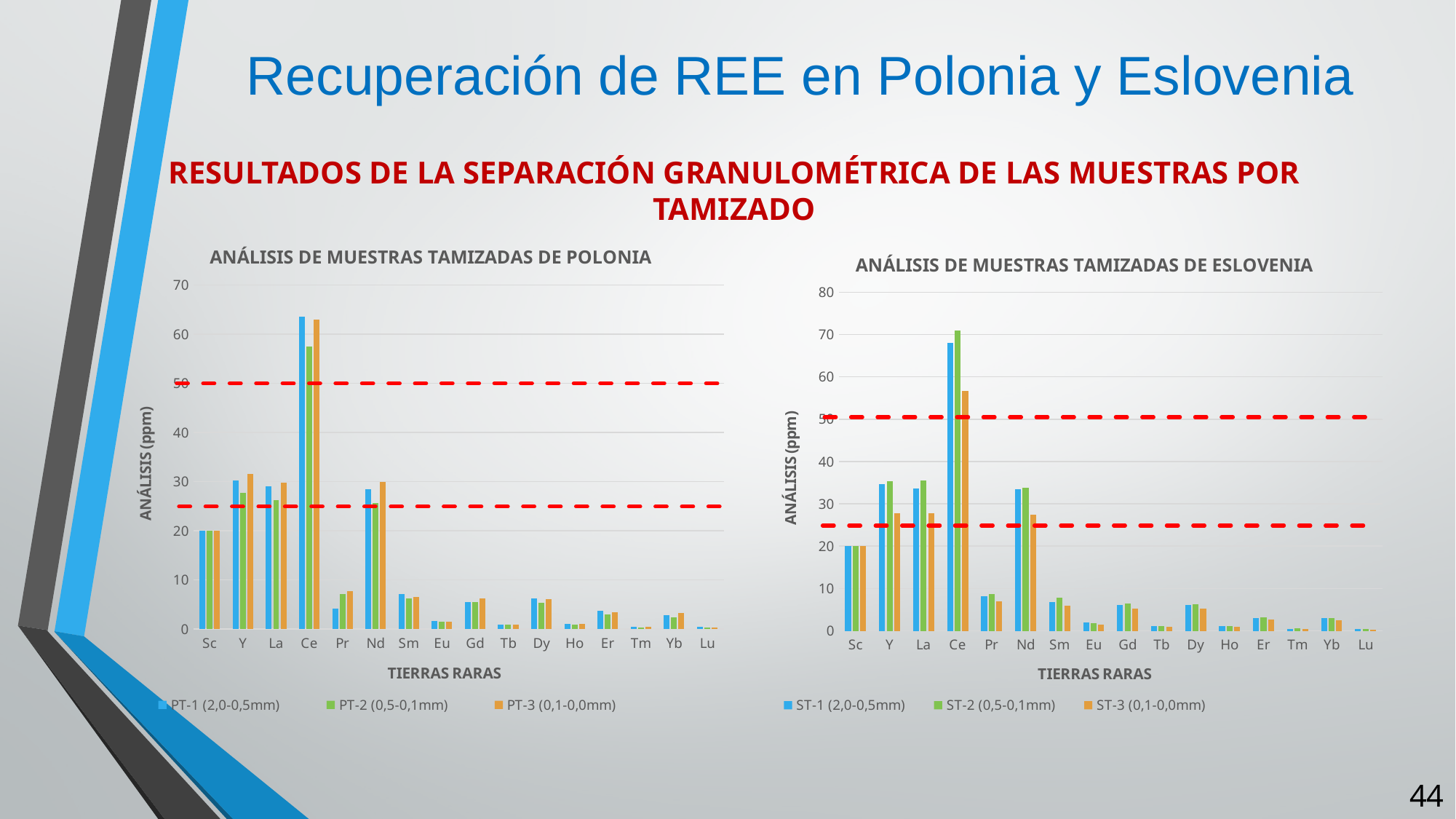
In the 'ANÁLISIS DE MUESTRAS TAMIZADAS DE POLONIA' chart, is the PT-1 (2,0-0,5mm) value for Pr greater or less than 10? less In the 'ANÁLISIS DE MUESTRAS TAMIZADAS DE ESLOVENIA' chart, is the ST-2 (0,5-0,1mm) value for Y greater or less than 30? greater In the 'ANÁLISIS DE MUESTRAS TAMIZADAS DE POLONIA' chart, is the PT-1 (2,0-0,5mm) value for Ce greater or less than 60? greater How many series does the legend of the 'ANÁLISIS DE MUESTRAS TAMIZADAS DE ESLOVENIA' chart list? 3 What is the y-axis title of the 'ANÁLISIS DE MUESTRAS TAMIZADAS DE ESLOVENIA' chart? ANÁLISIS (ppm) In the 'ANÁLISIS DE MUESTRAS TAMIZADAS DE POLONIA' chart, which category has the highest values? Ce In the 'ANÁLISIS DE MUESTRAS TAMIZADAS DE ESLOVENIA' chart, which category has the highest values? Ce How many rare earth categories are shown on the x axis of the 'ANÁLISIS DE MUESTRAS TAMIZADAS DE POLONIA' chart? 16 What type of chart is the 'ANÁLISIS DE MUESTRAS TAMIZADAS DE POLONIA' chart? bar chart In the 'ANÁLISIS DE MUESTRAS TAMIZADAS DE ESLOVENIA' chart, which is larger for Ce: ST-2 (0,5-0,1mm) or ST-3 (0,1-0,0mm)? ST-2 (0,5-0,1mm) In the 'ANÁLISIS DE MUESTRAS TAMIZADAS DE POLONIA' chart, which category has the larger PT-3 (0,1-0,0mm) value: Nd or Pr? Nd